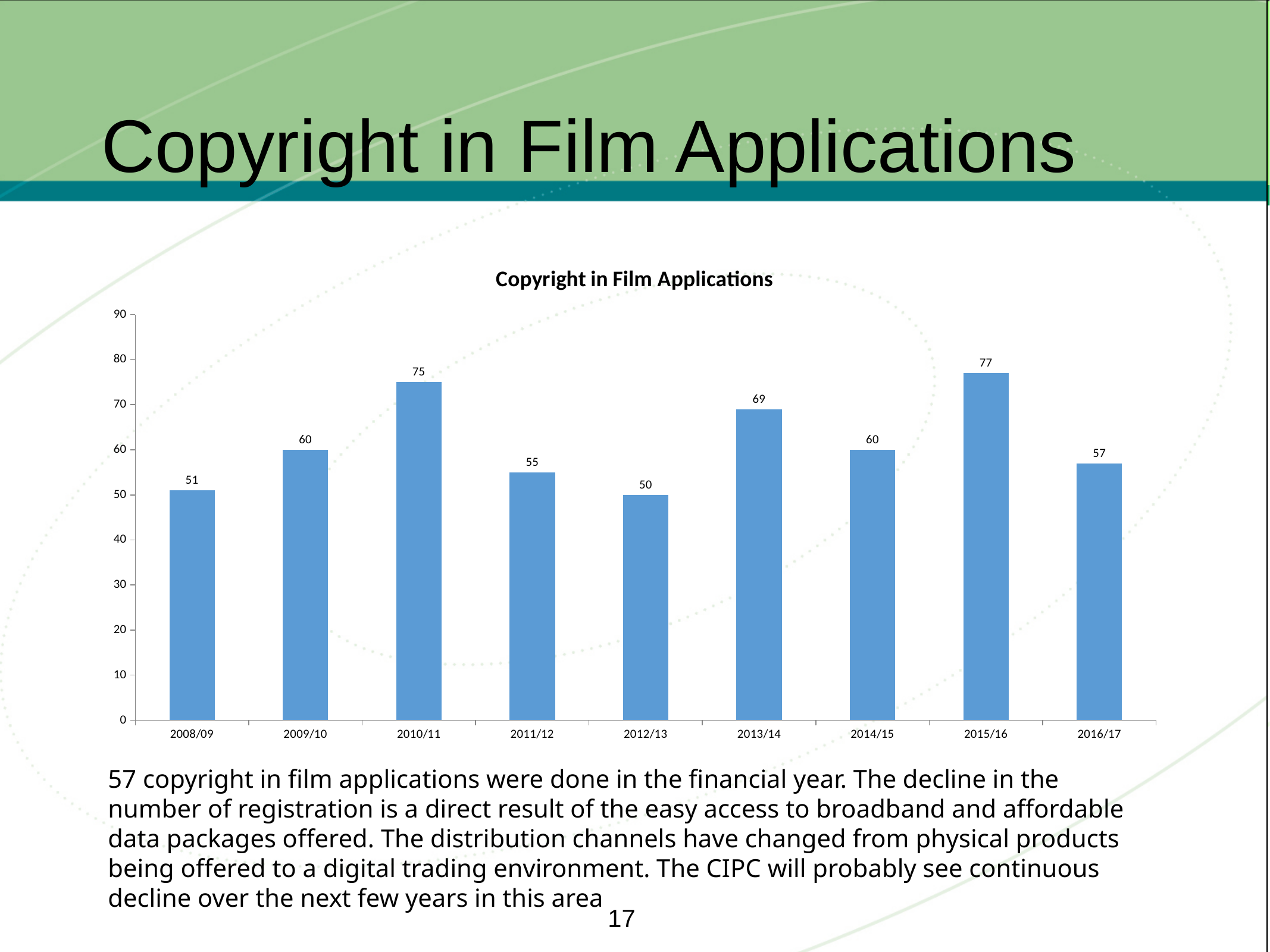
What is the value for 2012/13? 50 Which year has the lowest value? 2012/13 Which year has the highest value? 2015/16 What is the difference between the values for 2015/16 and 2016/17? 20 Is the value for 2011/12 greater or less than 60? less Do the values rise or fall from 2015/16 to 2016/17? fall What is the value for 2016/17? 57 What is the value for 2010/11? 75 What kind of chart is shown? bar chart Which is larger, the value for 2013/14 or the value for 2014/15? 2013/14 How many years are shown on the x axis? 9 What is the title of the chart? Copyright in Film Applications